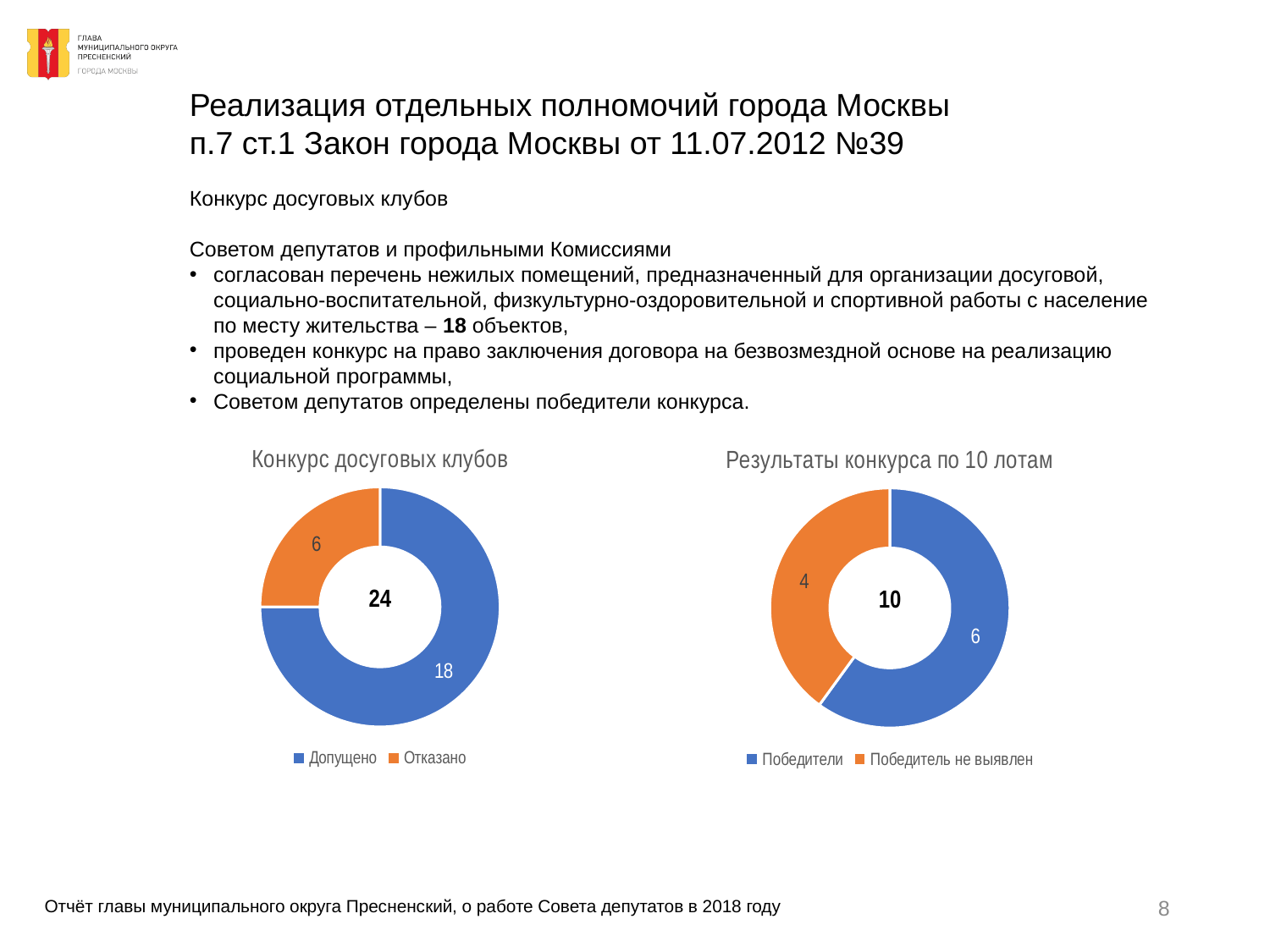
In the chart titled "Конкурс досуговых клубов", what is the difference between "Допущено" and "Отказано"? 12 In the chart titled "Результаты конкурса по 10 лотам", which category is the smallest? Победитель не выявлен In the chart titled "Результаты конкурса по 10 лотам", what is the value for "Победители"? 6 What type of chart is the chart titled "Результаты конкурса по 10 лотам"? Donut (pie) chart In the chart titled "Результаты конкурса по 10 лотам", what share of the total does "Победители" represent? 60% In the chart titled "Конкурс досуговых клубов", what is the value for "Отказано"? 6 In the chart titled "Результаты конкурса по 10 лотам", what is the value for "Победитель не выявлен"? 4 In the chart titled "Конкурс досуговых клубов", what number is shown in the centre of the donut? 24 How many categories does the legend of the chart titled "Конкурс досуговых клубов" list? 2 In the chart titled "Конкурс досуговых клубов", what is the value for "Допущено"? 18 In the chart titled "Конкурс досуговых клубов", which category is the largest? Допущено In the chart titled "Конкурс досуговых клубов", what share of the total does "Отказано" represent? 25%